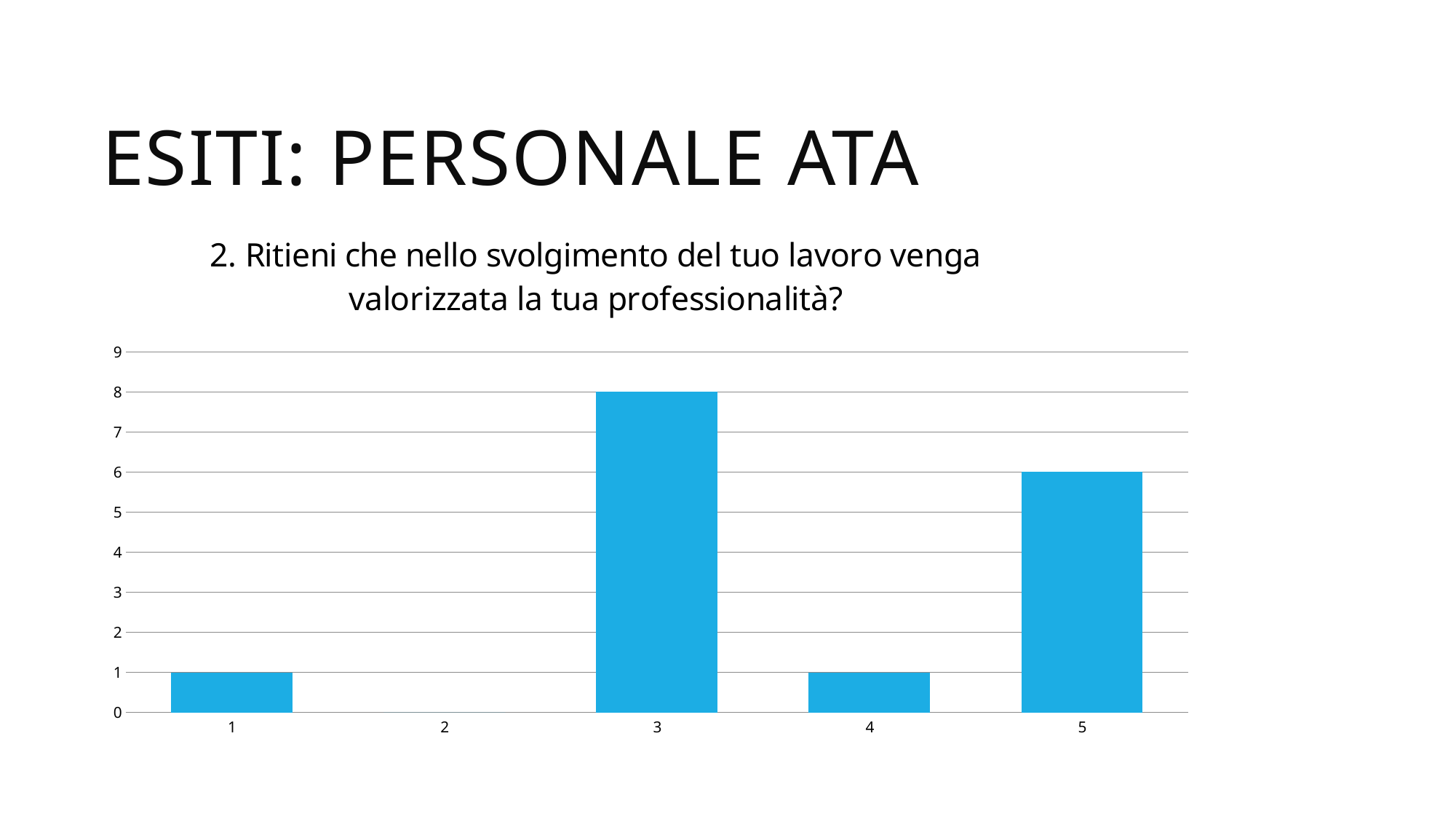
How many categories are shown on the x axis of the chart? 5 What kind of chart is shown on the slide? bar chart What is the value for category 5? 6 Which category has the highest value? 3 Which is larger, the value for category 4 or the value for category 5? 5 What is the value for category 3? 8 What is the value for category 2? 0 Which category has the lowest value? 2 Is the value for category 3 greater or less than 5? greater What is the difference between the values for category 3 and category 5? 2 What is the value for category 1? 1 What is the title of the chart? 2. Ritieni che nello svolgimento del tuo lavoro venga valorizzata la tua professionalità?